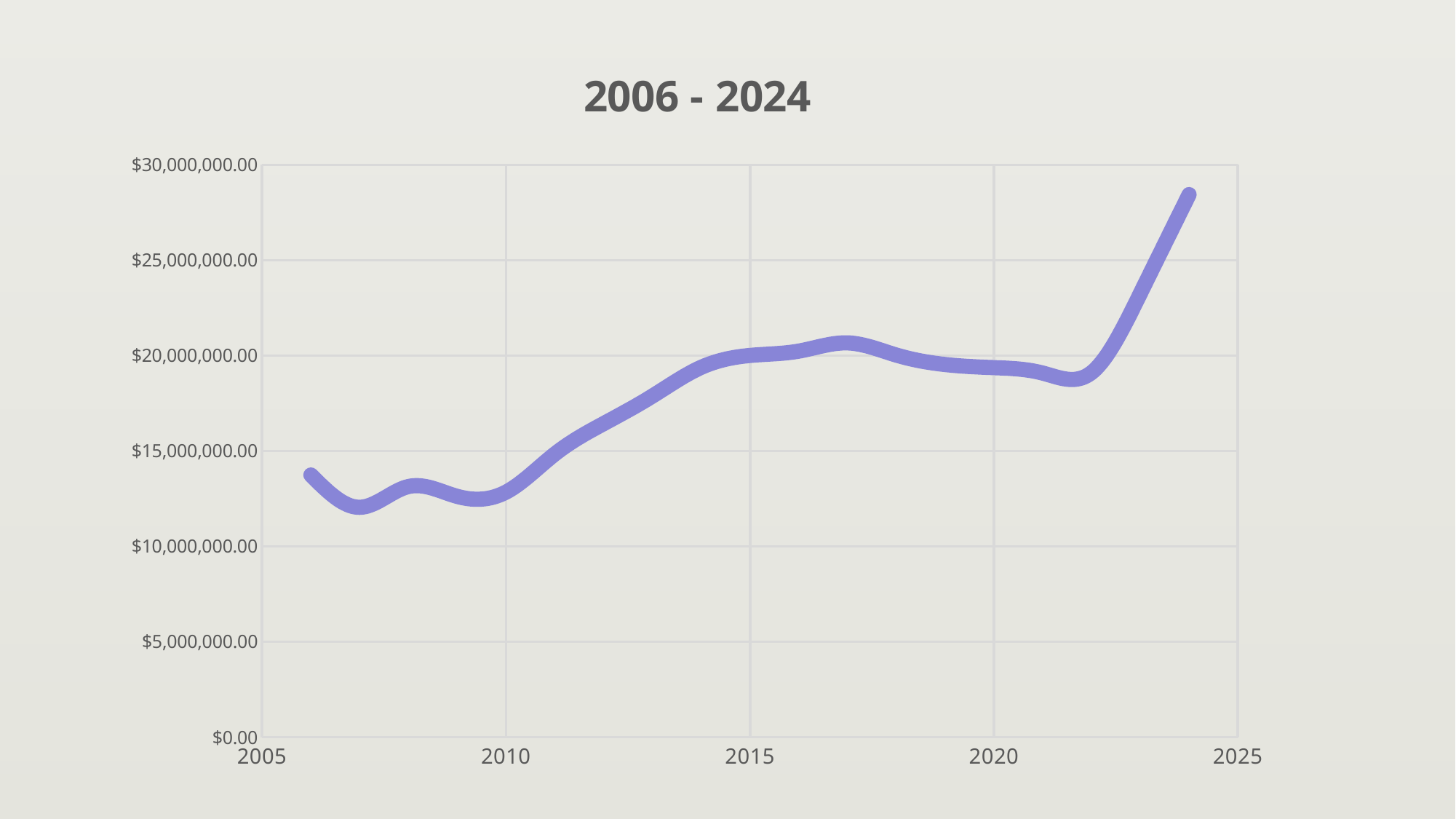
Is the value for 2006 greater or less than $10,000,000.00? greater Which is larger, the value for 2015 or the value for 2010? 2015 Is the value for 2010 greater or less than $15,000,000.00? less Overall, does the line rise or fall from 2006 to 2024? rise Which is larger, the value for 2024 or the value for 2006? 2024 What kind of chart is shown on the slide? line chart Is the value for 2024 greater or less than $25,000,000.00? greater What is the title of the chart? 2006 - 2024 In which year does the line reach its highest value? 2024